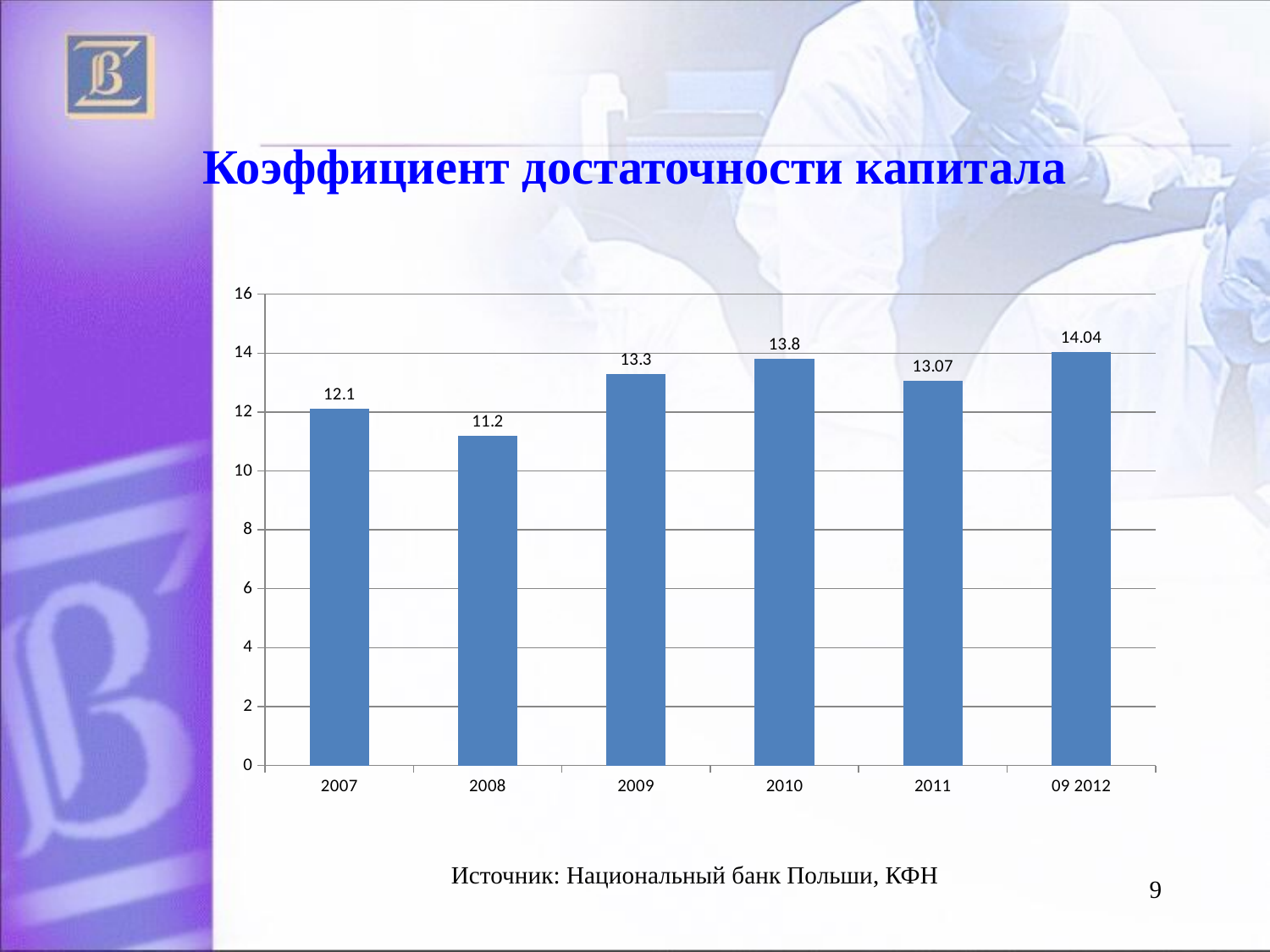
What kind of chart is shown on the slide? bar chart What is the difference between the values for 2010 and 2008? 2.6 Which is larger, the value for 2007 or the value for 2011? 2011 What value is shown for 2011? 13.07 What is the title of the chart on the slide? Коэффициент достаточности капитала What value is shown for 09 2012? 14.04 What is the capital adequacy ratio value shown for 2009? 13.3 Which category has the highest value on the chart? 09 2012 How many bars are shown on the chart? 6 Did the value rise or fall from 2010 to 2011? fall Which year has the lowest value on the chart? 2008 Is the value for 2008 greater or less than 12? less